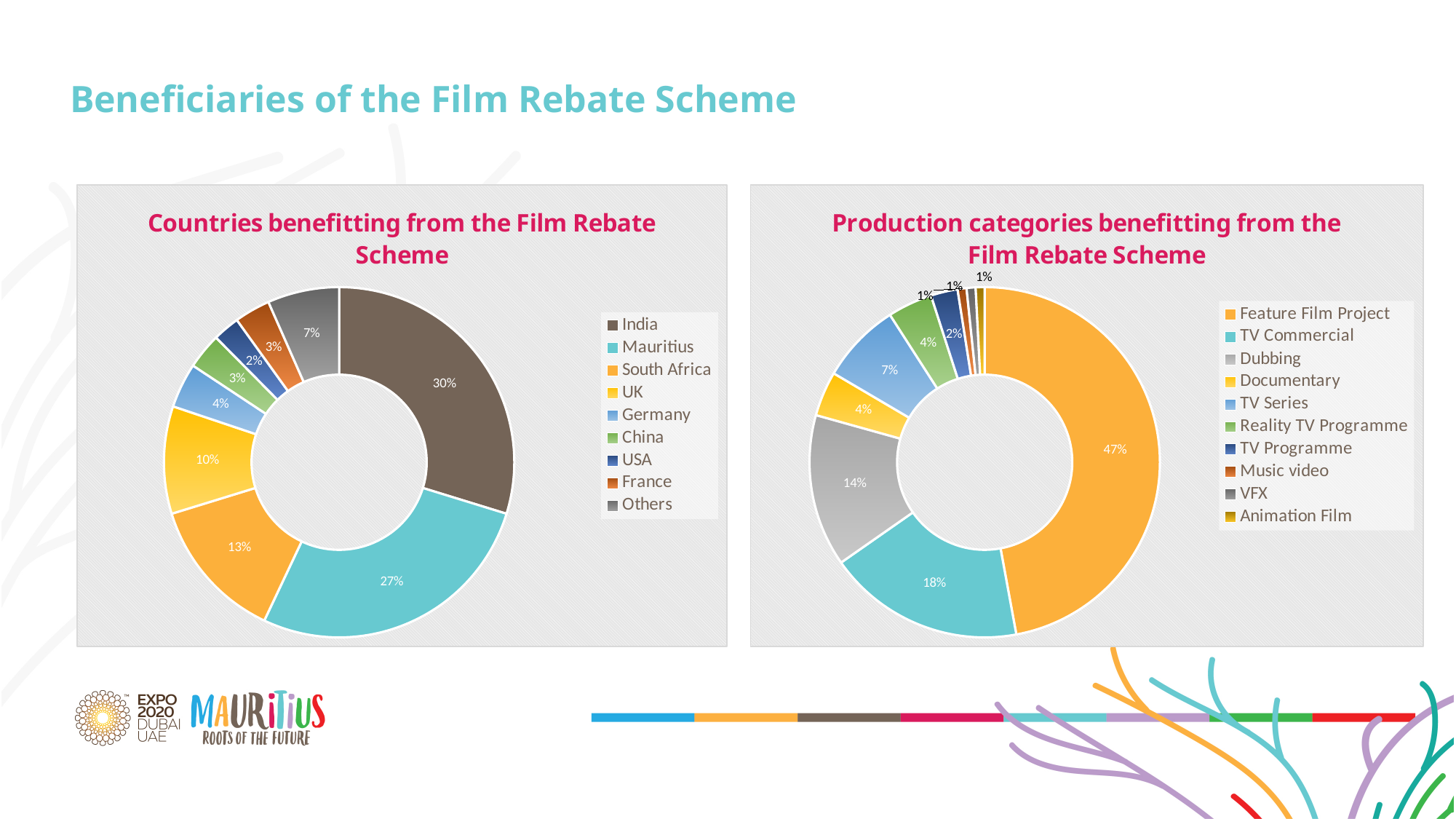
What kind of chart is the 'Production categories benefitting from the Film Rebate Scheme' chart? Doughnut (pie) chart How many categories are listed in the legend of the 'Countries benefitting from the Film Rebate Scheme' chart? 9 In the 'Production categories benefitting from the Film Rebate Scheme' chart, what is the difference between the shares of TV Commercial and TV Series? 11% In the 'Production categories benefitting from the Film Rebate Scheme' chart, what share does Feature Film Project have? 47% In the 'Production categories benefitting from the Film Rebate Scheme' chart, which category has the largest share? Feature Film Project In the 'Production categories benefitting from the Film Rebate Scheme' chart, what share does Dubbing have? 14% In the 'Countries benefitting from the Film Rebate Scheme' chart, what is the difference between the shares of South Africa and the UK? 3% How many categories are listed in the legend of the 'Production categories benefitting from the Film Rebate Scheme' chart? 10 In the 'Countries benefitting from the Film Rebate Scheme' chart, what share does India have? 30% In the 'Countries benefitting from the Film Rebate Scheme' chart, what share does Mauritius have? 27% In the 'Countries benefitting from the Film Rebate Scheme' chart, which country has the largest share? India In the 'Countries benefitting from the Film Rebate Scheme' chart, which is larger, the share for Germany or the share for USA? Germany